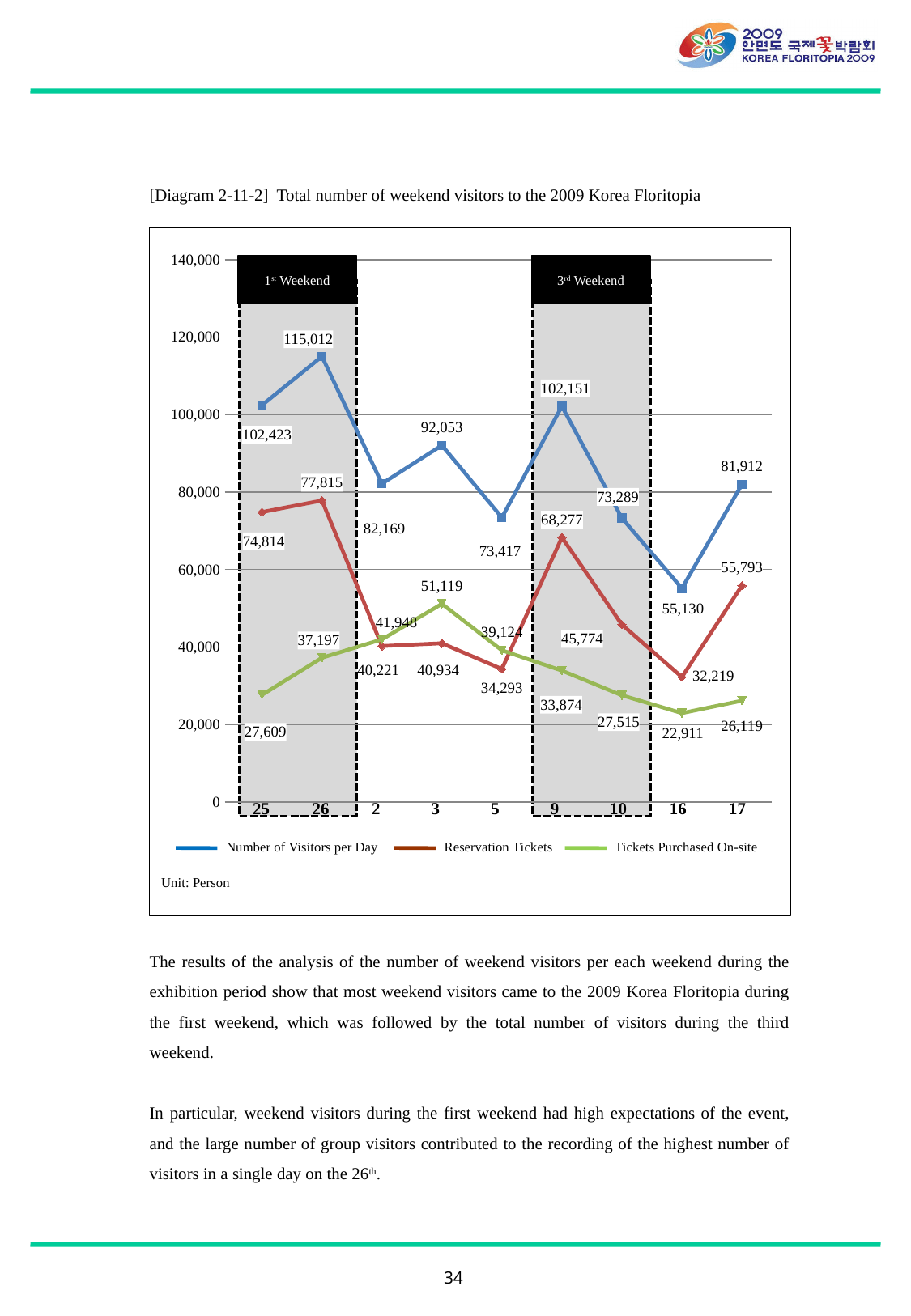
How many days are shown on the x axis? 9 What is the Number of Visitors per Day on the 26th? 115,012 What is the value for Reservation Tickets on the 9th? 68,277 On which day is the Number of Visitors per Day highest? 26 What kind of chart is shown? Line chart What unit is stated for the values in the chart? Person On which day is the Number of Visitors per Day lowest? 16 Which is larger on the 2nd: Reservation Tickets or Tickets Purchased On-site? Tickets Purchased On-site What is the difference between the Number of Visitors per Day on the 26th and on the 16th? 59,882 What is the value for Tickets Purchased On-site on the 3rd? 51,119 On which day is Tickets Purchased On-site lowest? 16 How many series does the legend list? 3